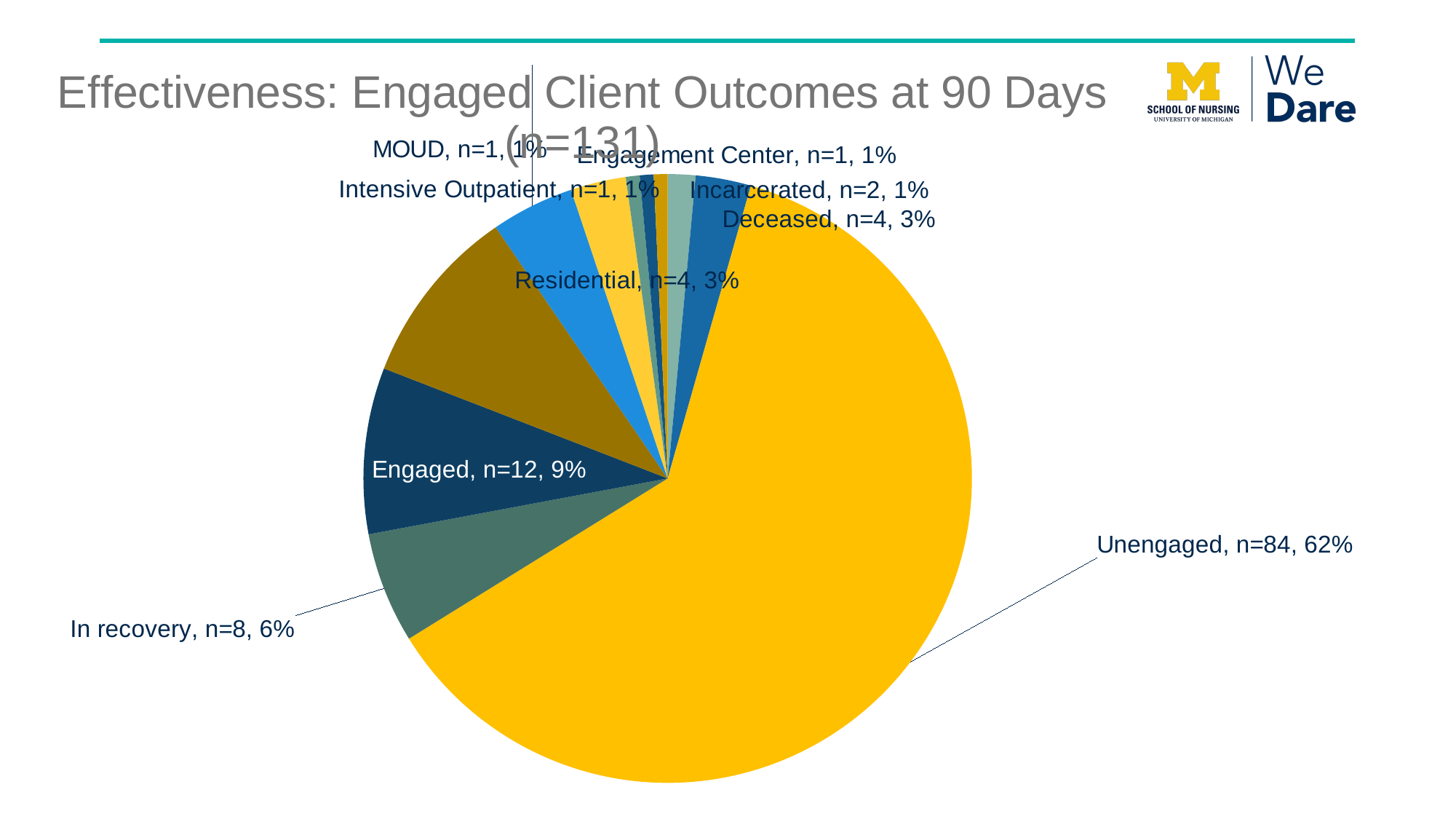
What is the title of the chart on the slide? Effectiveness: Engaged Client Outcomes at 90 Days (n=131) What is the n value for the Unengaged slice? n=84 What is the n value for the Engaged slice? n=12 What percentage of the pie does the In recovery slice represent? 6% What is the n value for the Incarcerated slice? n=2 Which slice is larger, Engaged or In recovery? Engaged What is the difference in n between the Unengaged and Engaged slices? 72 What percentage of the pie does the Residential slice represent? 3% Which category has the largest slice of the pie? Unengaged What is the n value for the Deceased slice? n=4 What percentage of the pie does the Unengaged slice represent? 62% What kind of chart is shown on the slide? pie chart